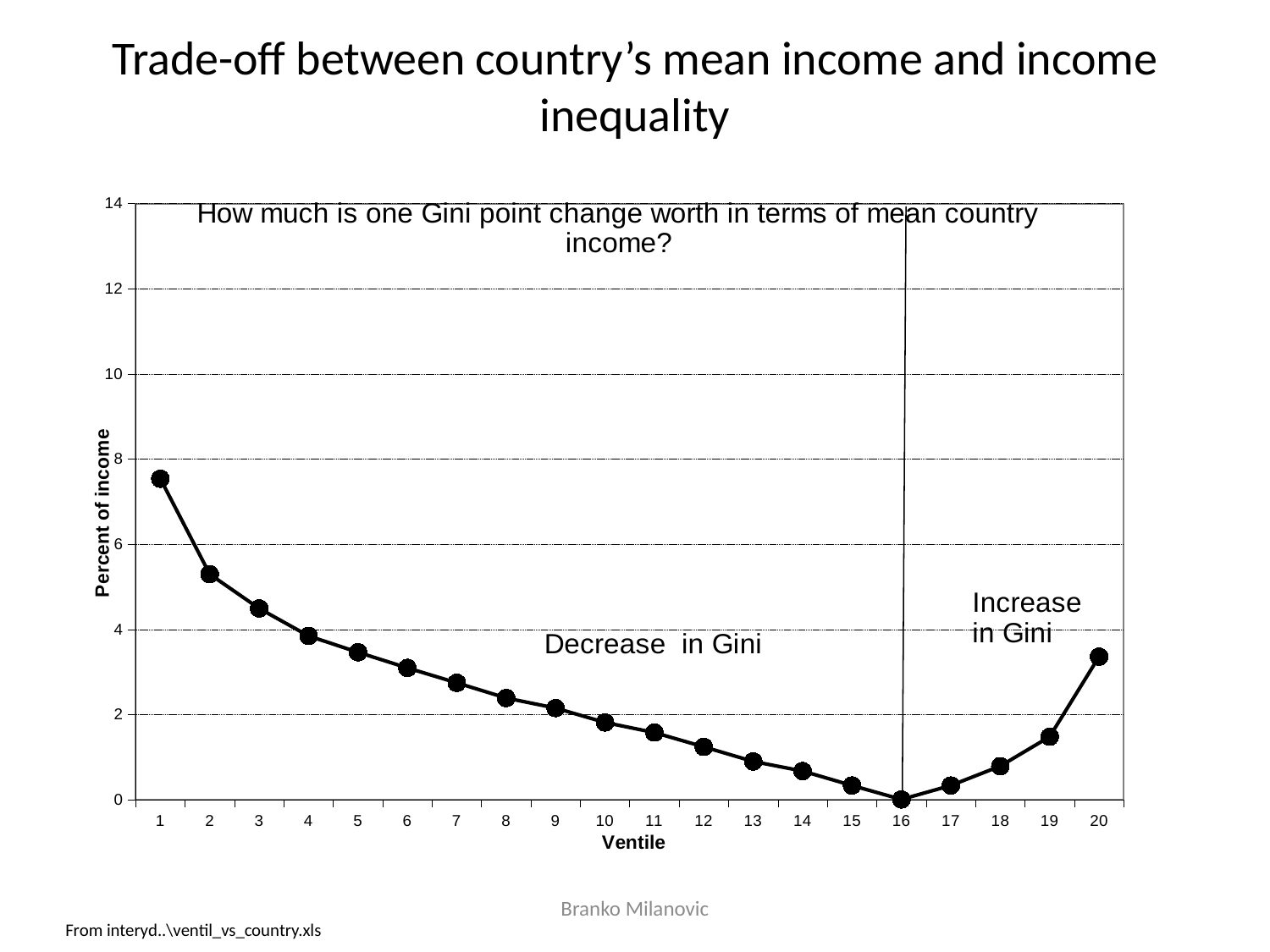
Is the value for ventile 1 greater or less than 6? greater Is the value for ventile 13 greater or less than 2? less How many ventiles are plotted along the x axis? 20 Which ventile has the lowest percent of income? 16 Do the values rise or fall from ventile 16 to ventile 20? Rise Is the value for ventile 2 greater or less than 4? greater Which has the larger percent of income, ventile 1 or ventile 20? Ventile 1 What kind of chart is shown on the slide? Line chart What is the label of the y axis? Percent of income Which ventile has the highest percent of income? 1 Do the values rise or fall from ventile 1 to ventile 16? Fall